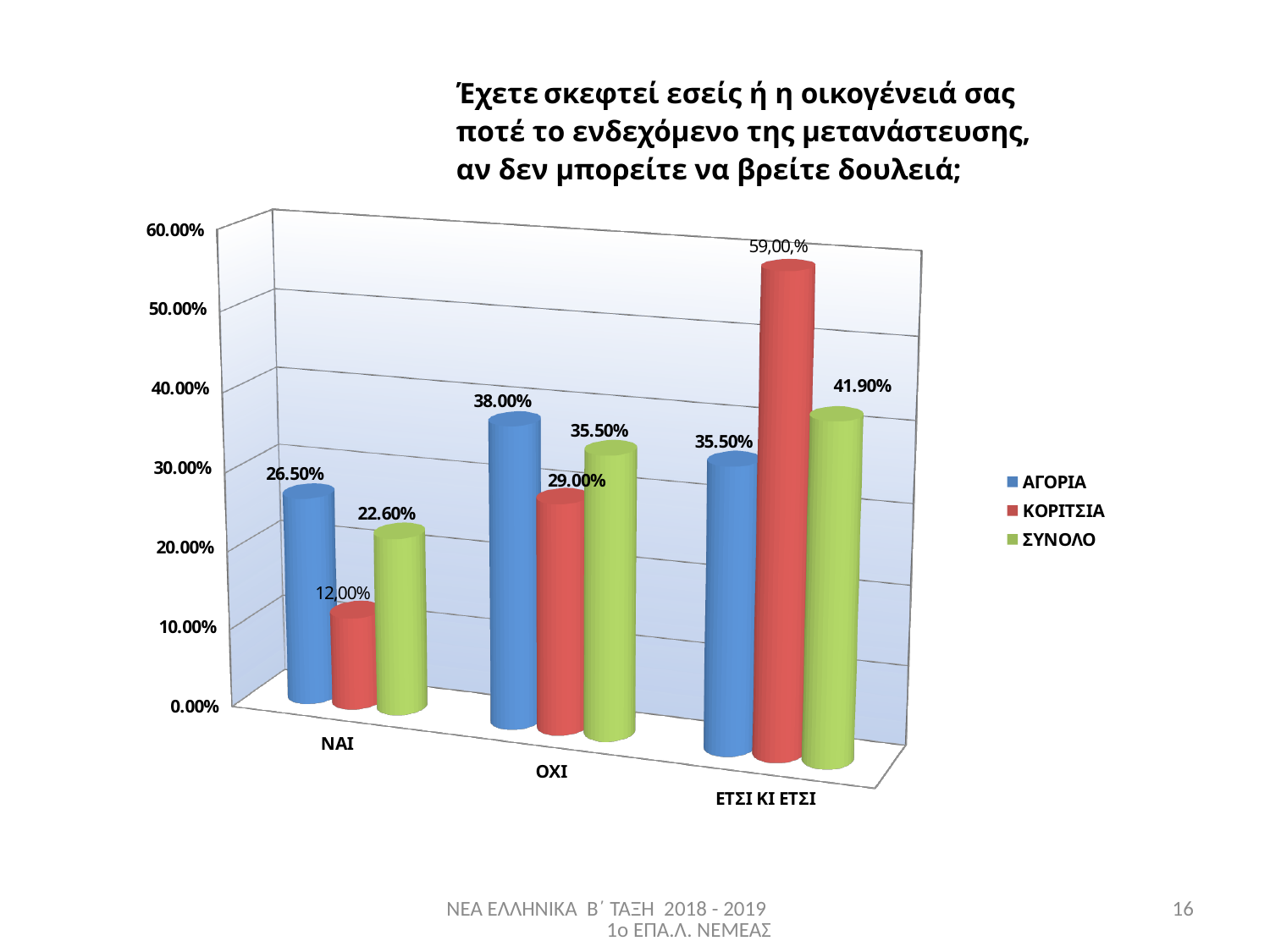
In which category is the ΚΟΡΙΤΣΙΑ value highest? ΕΤΣΙ ΚΙ ΕΤΣΙ How many categories are shown on the x axis? 3 Which is larger: the ΑΓΟΡΙΑ value for ΟΧΙ or the ΑΓΟΡΙΑ value for ΕΤΣΙ ΚΙ ΕΤΣΙ? ΟΧΙ In which category is the ΣΥΝΟΛΟ value lowest? ΝΑΙ How many series does the legend list? 3 What is the difference between the ΑΓΟΡΙΑ values for ΟΧΙ and ΝΑΙ? 11.50% What is the value for ΑΓΟΡΙΑ in the ΝΑΙ category? 26.50% What is the value for ΣΥΝΟΛΟ in the ΕΤΣΙ ΚΙ ΕΤΣΙ category? 41.90% Is the ΚΟΡΙΤΣΙΑ value for ΕΤΣΙ ΚΙ ΕΤΣΙ greater or less than 50.00%? greater What is the value for ΑΓΟΡΙΑ in the ΟΧΙ category? 38.00% What is the value for ΚΟΡΙΤΣΙΑ in the ΟΧΙ category? 29.00% What kind of chart is shown on the slide? bar chart